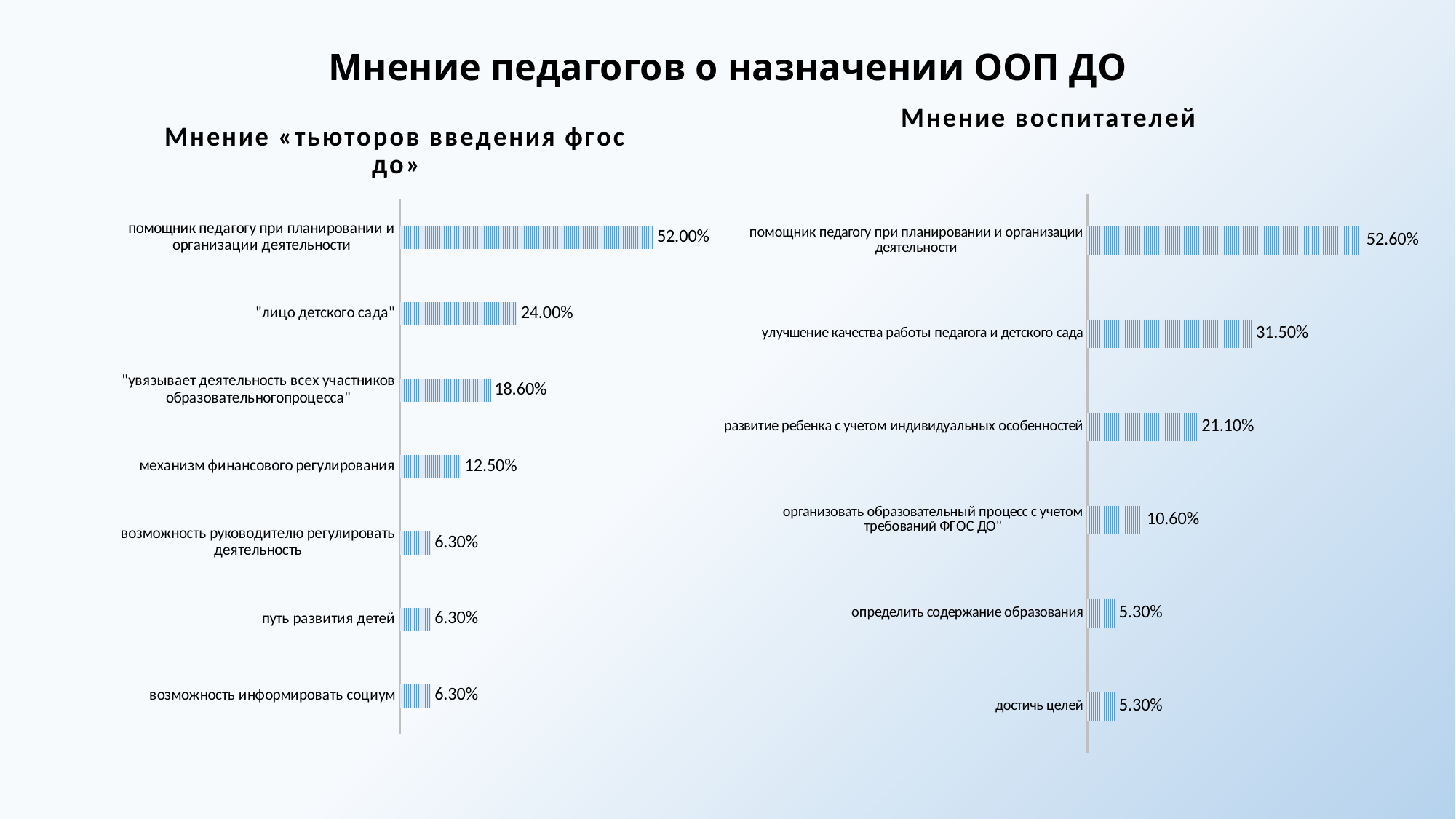
How many categories are shown in the chart "Мнение воспитателей"? 6 In the chart "Мнение «тьюторов введения фгос до»", what is the value for "механизм финансового регулирования"? 12.50% In the chart "Мнение воспитателей", what is the difference between the values for "помощник педагогу при планировании и организации деятельности" and "улучшение качества работы педагога и детского сада"? 21.10% In the chart "Мнение воспитателей", what is the value for "достичь целей"? 5.30% How many categories are shown in the chart "Мнение «тьюторов введения фгос до»"? 7 In the chart "Мнение воспитателей", which category has the highest value? помощник педагогу при планировании и организации деятельности In the chart "Мнение воспитателей", which is larger: the value for "развитие ребенка с учетом индивидуальных особенностей" or for "организовать образовательный процесс с учетом требований ФГОС ДО"? развитие ребенка с учетом индивидуальных особенностей What type of chart is "Мнение воспитателей"? Bar chart In the chart "Мнение «тьюторов введения фгос до»", what is the difference between the values for "лицо детского сада" and "увязывает деятельность всех участников образовательногопроцесса"? 5.40% In the chart "Мнение воспитателей", what is the value for "улучшение качества работы педагога и детского сада"? 31.50% In the chart "Мнение «тьюторов введения фгос до»", what is the value for "лицо детского сада"? 24.00% In the chart "Мнение «тьюторов введения фгос до»", which category has the highest value? помощник педагогу при планировании и организации деятельности